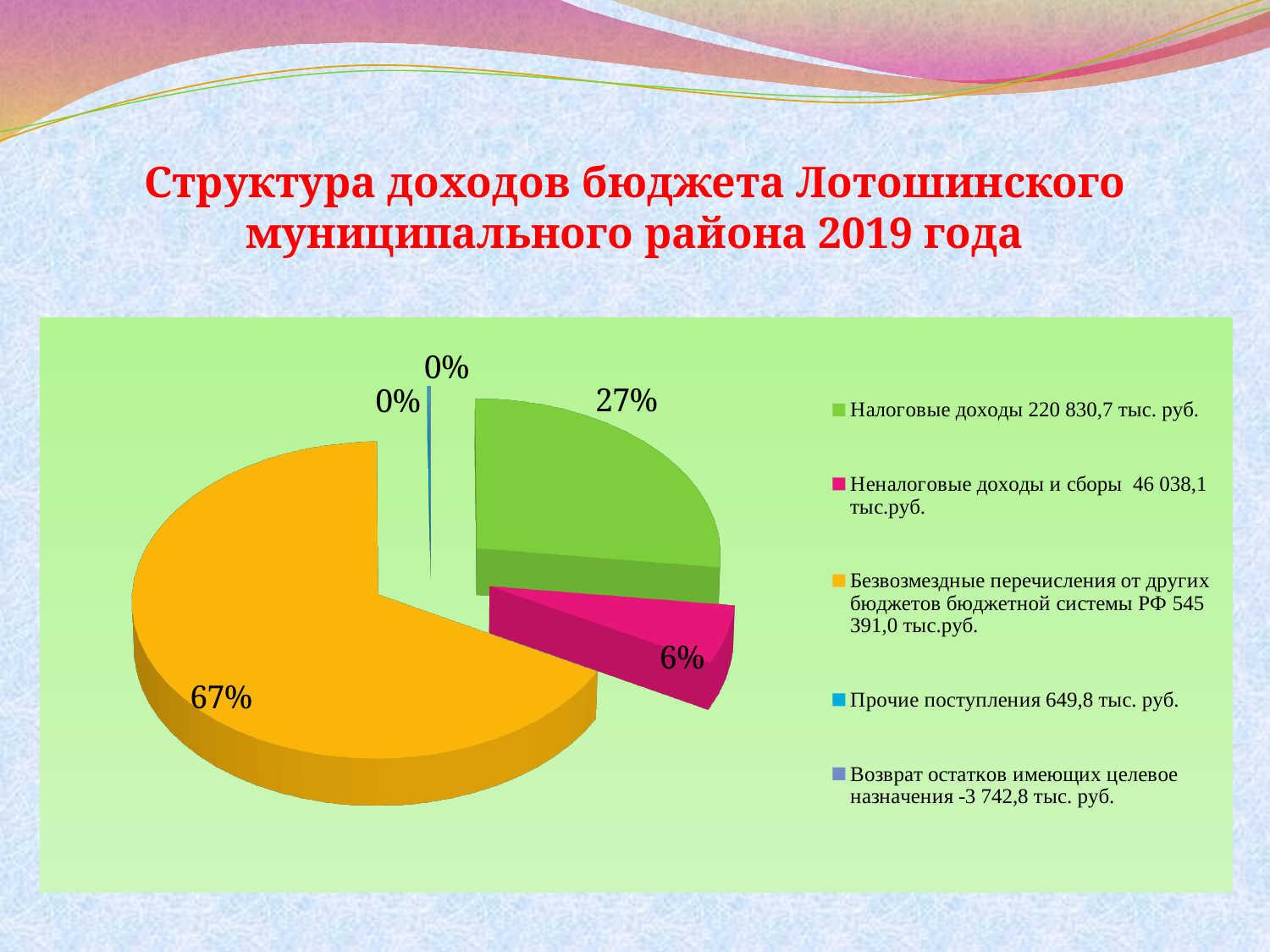
What percentage share does the slice for Налоговые доходы have? 27% How many categories does the legend list? 5 Which category has the largest slice of the pie? Безвозмездные перечисления от других бюджетов бюджетной системы РФ What percentage share does the slice for Неналоговые доходы и сборы have? 6% What is the difference in percentage points between the share for Безвозмездные перечисления (67%) and the share for Налоговые доходы (27%)? 40 percentage points What kind of chart is shown on the slide? pie chart What percentage share is shown for Прочие поступления? 0% According to the legend, what is the amount of Налоговые доходы? 220 830,7 тыс. руб. What colour is the slice for Неналоговые доходы и сборы? pink Which is larger: the share for Налоговые доходы or the share for Неналоговые доходы и сборы? Налоговые доходы According to the legend, what is the amount of Прочие поступления? 649,8 тыс. руб.